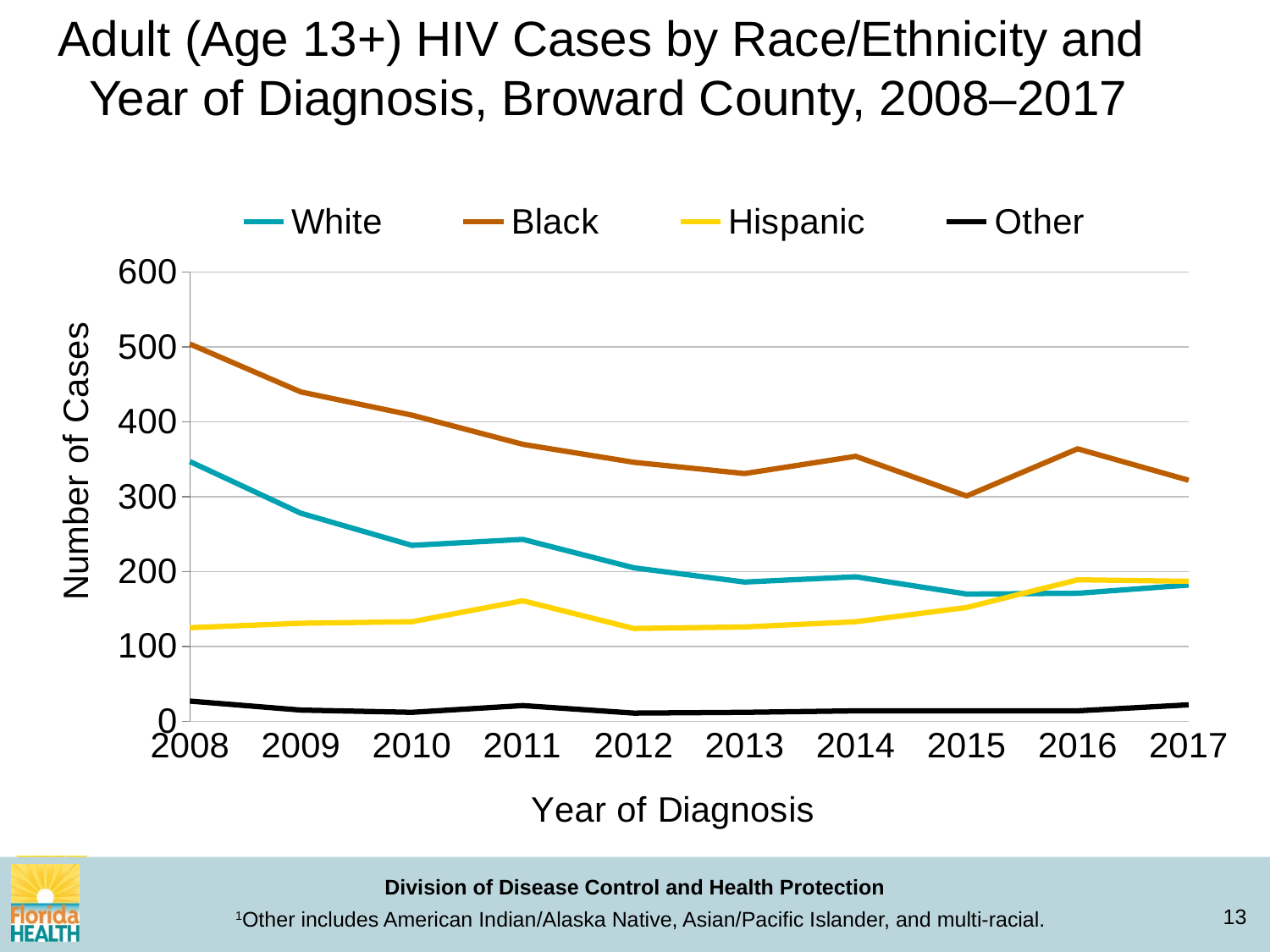
How many years of diagnosis are plotted along the x axis? 10 How many series does the legend list? 4 What kind of chart is shown on the slide? line chart Is the value for Other in 2008 greater or less than 100? less Is the value for White in 2017 greater or less than 200? less Which race/ethnicity has the highest number of cases in 2008? Black Is the value for Black in 2009 greater or less than 400? greater Which race/ethnicity has the lowest number of cases in 2017? Other What is the label of the y axis? Number of Cases Does the number of cases for White rise or fall from 2008 to 2017? fall In 2008, which is larger, the value for White or the value for Hispanic? White